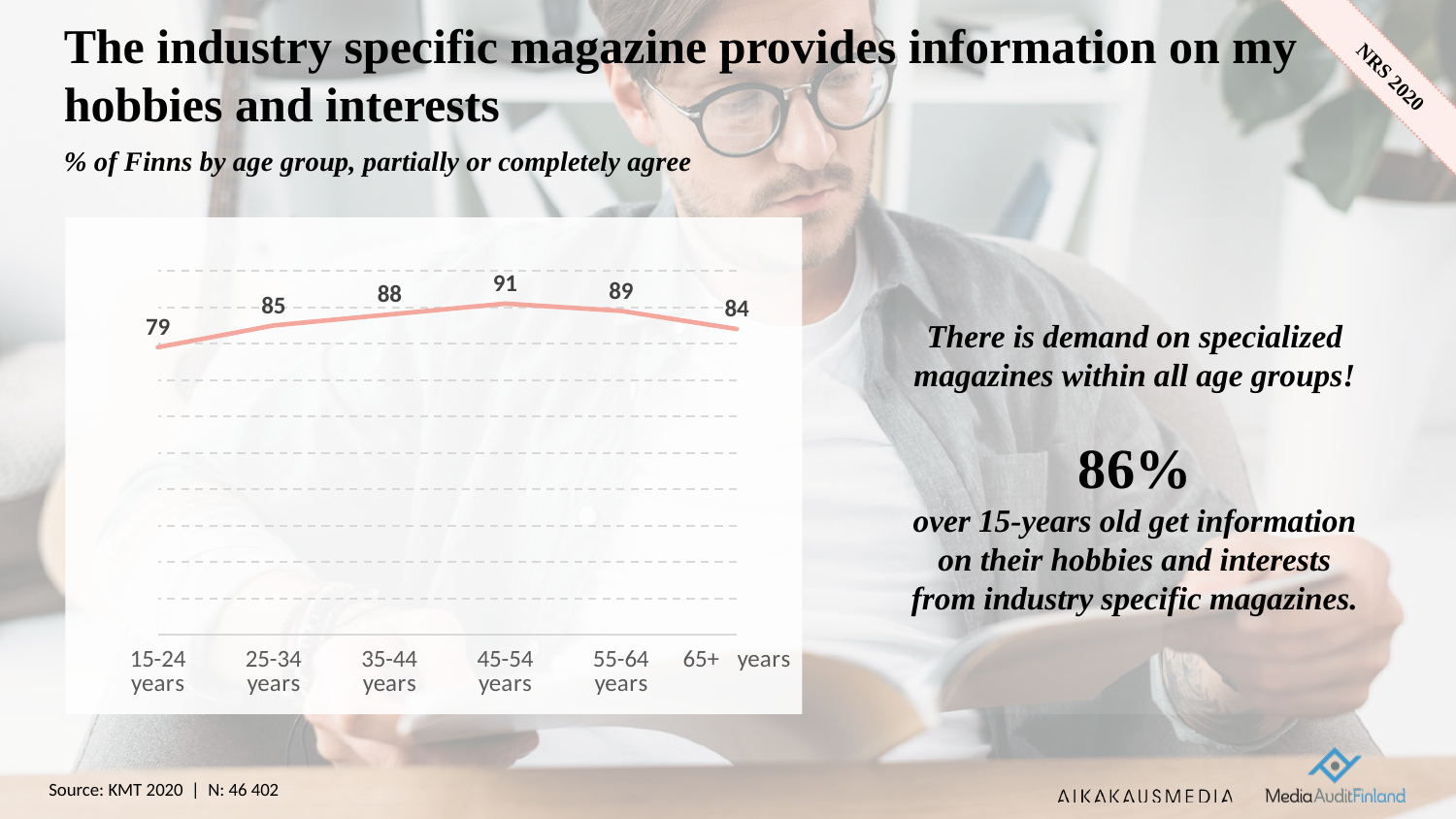
What is the difference between the values for 35-44 years and 65+ years? 4 What is the value for the 65+ years age group? 84 Do the values rise or fall from 15-24 years to 45-54 years? Rise What is the difference between the values for 45-54 years and 15-24 years? 12 What is the value for the 45-54 years age group? 91 How many age groups are plotted on the chart? 6 What kind of chart is shown on the slide? Line chart What is the value for the 15-24 years age group? 79 Which age group has the highest value? 45-54 years Which is larger, the value for 25-34 years or the value for 55-64 years? 55-64 years What colour is the line on the chart? Red Which age group has the lowest value? 15-24 years